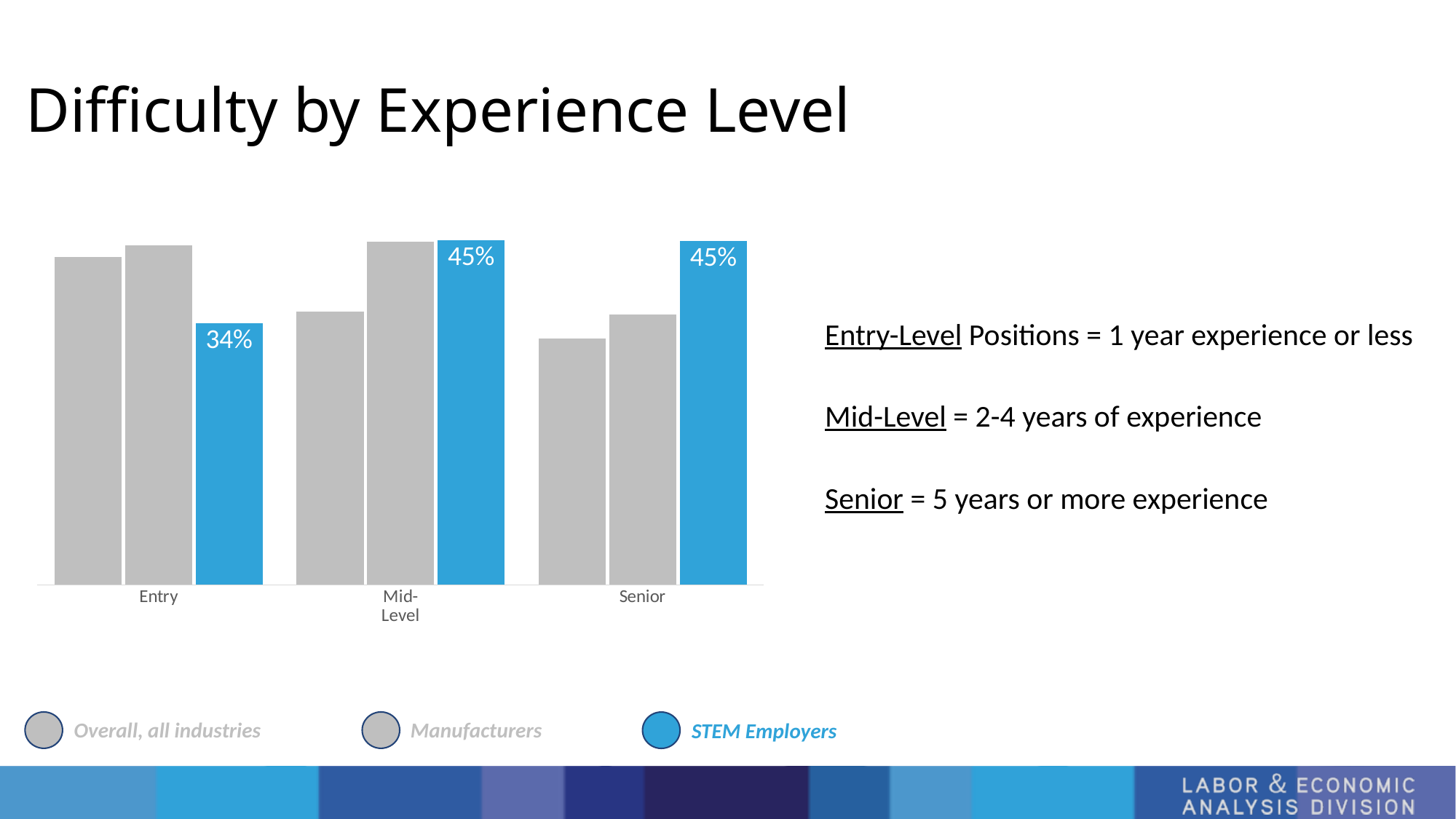
Among the STEM Employers bars, which experience level has the lowest value? Entry What is the difference between the STEM Employers values for Mid-Level and Entry? 11% In the Entry group, which series has the lowest bar? STEM Employers What is the value for STEM Employers at the Senior level? 45% What is the value for STEM Employers at the Entry level? 34% What is the value for STEM Employers at the Mid-Level? 45% How many series does the legend list? 3 What kind of chart is shown on the slide? Bar chart What colour are the STEM Employers bars? Blue How many experience-level categories are shown on the x axis? 3 In the Senior group, is the bar for STEM Employers or Manufacturers larger? STEM Employers In the Senior group, which series has the lowest bar? Overall, all industries